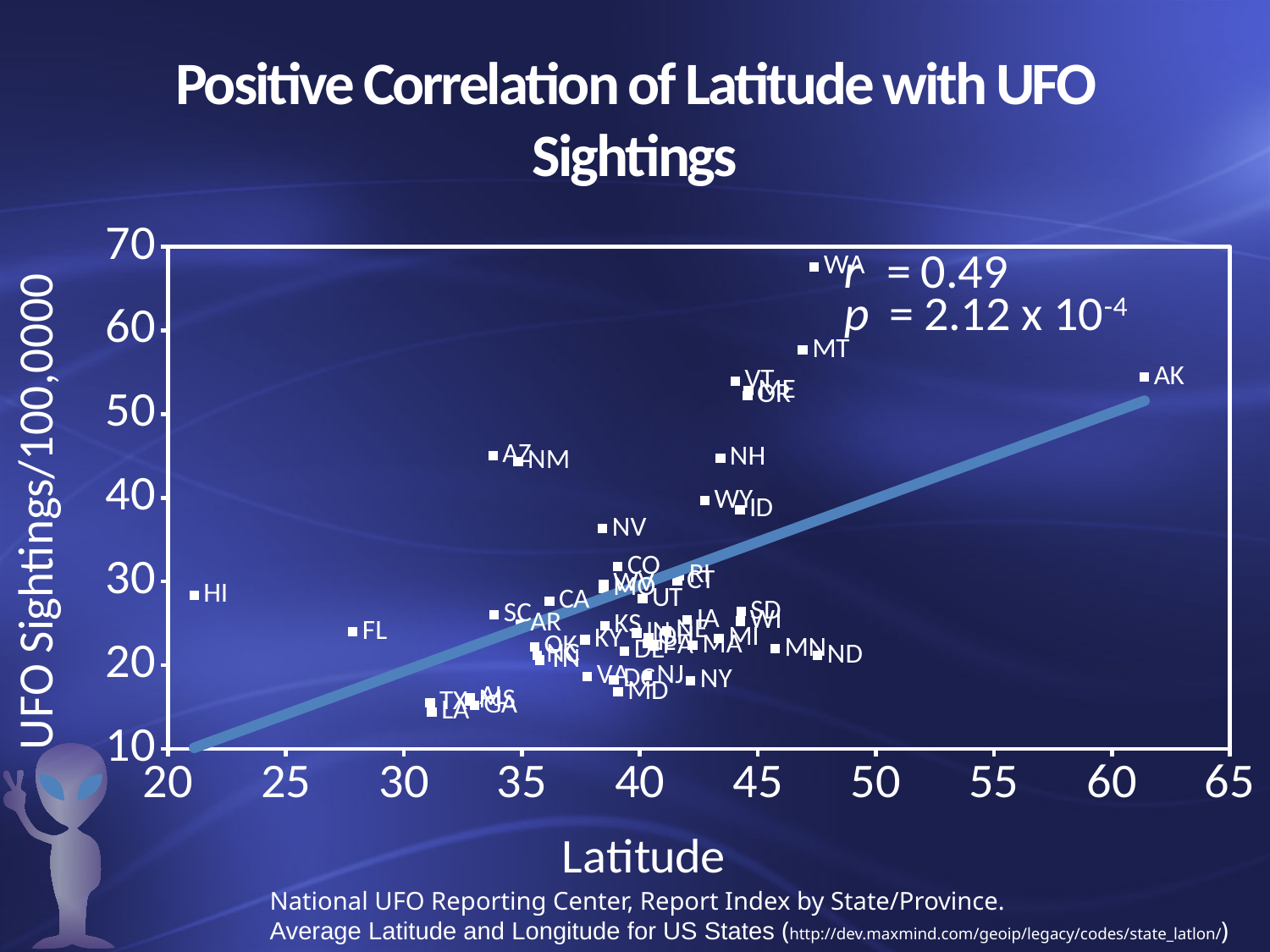
Is the UFO sightings value for FL greater or less than 30? less Which state has the highest UFO sightings per 100,000 on the chart? WA What correlation coefficient r is printed on the chart? 0.49 Which state is plotted at the highest latitude? AK Do UFO sightings generally rise or fall as latitude increases along the x axis? rise Is the UFO sightings value for AK greater or less than 50? greater Which has more UFO sightings per 100,000, MT or NH? MT What kind of chart is shown on the slide? scatter plot Which has more UFO sightings per 100,000, FL or NV? NV Which state is plotted at the lowest latitude? HI Is the UFO sightings value for WA greater or less than 60? greater